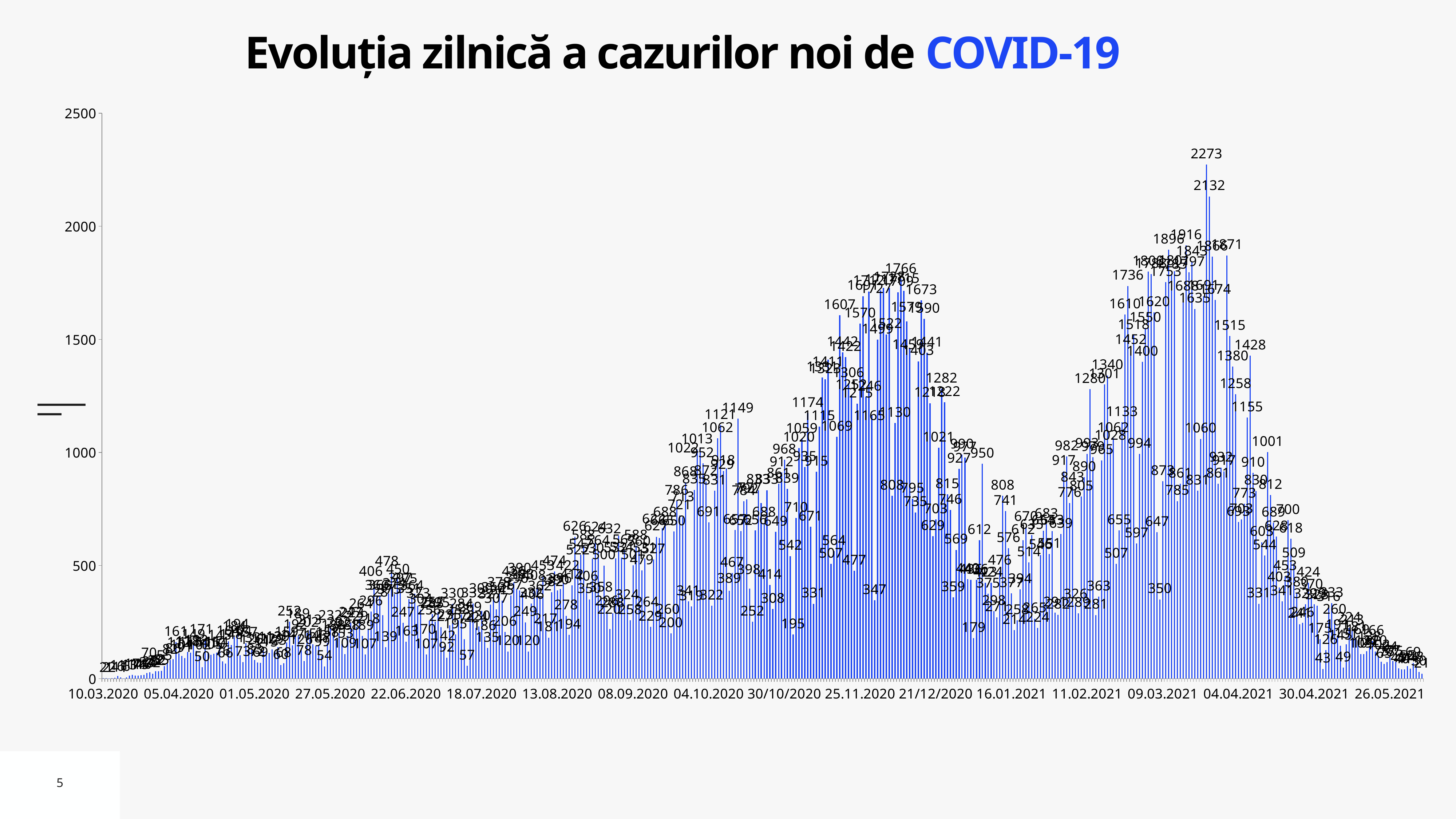
Which is larger: the peak of the late-2020 wave labelled 1766 or the peak of the 2021 wave labelled 2273? 2273 What is the highest daily value labelled on the chart? 2273 What is the difference between the 2021 peak of 2273 and the late-2020 peak of 1766? 507 What is the difference between the two highest labelled values, 2273 and 2132? 141 What is the first date label on the horizontal axis? 10.03.2020 What is the second-highest value labelled on the chart, next to the 2273 peak? 2132 Is the highest bar on the chart greater or less than 2000? greater What is the highest value shown on the vertical axis? 2500 What kind of chart is shown on the slide? bar chart Are the bars at the start of the chart (around 10.03.2020) greater or less than 500? less What is the title of the chart? Evoluția zilnică a cazurilor noi de COVID-19 What is the last date label on the horizontal axis? 26.05.2021